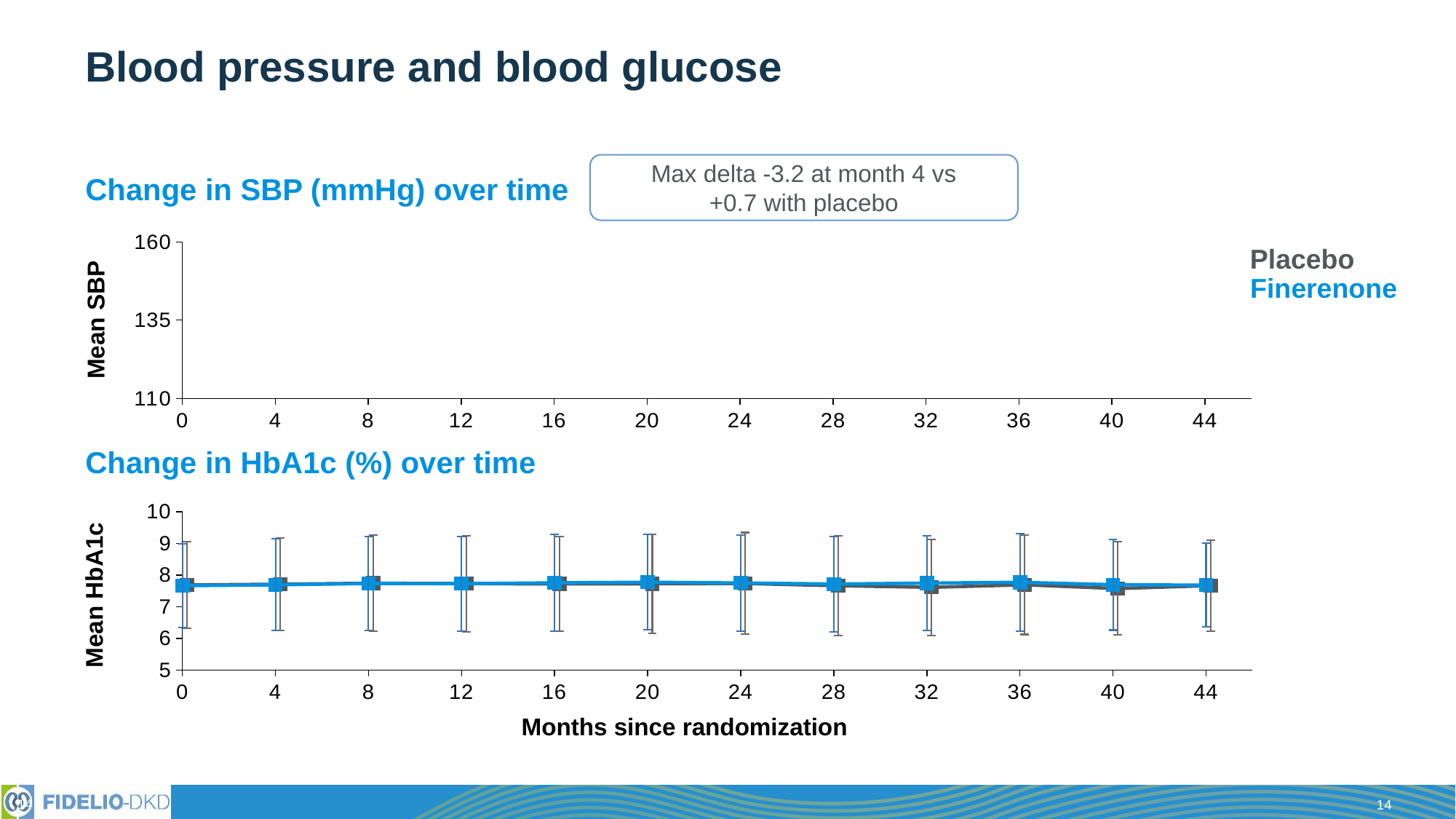
In the 'Change in HbA1c (%) over time' chart, is the Finerenone value at month 36 greater or less than 7? greater In the 'Change in HbA1c (%) over time' chart, is the Placebo value at month 0 greater or less than 6? greater In the 'Change in HbA1c (%) over time' chart, is the Finerenone value at month 20 greater or less than 8? less According to the callout on the SBP chart, what is the maximum delta in SBP with finerenone and at which month? -3.2 at month 4 In the 'Change in HbA1c (%) over time' chart, how many time points are plotted along the x axis? 12 Which colour represents Finerenone in the legend? blue In the 'Change in HbA1c (%) over time' chart, do the mean HbA1c values rise, fall or stay roughly flat from month 0 to month 44? roughly flat What kind of chart is the 'Change in HbA1c (%) over time' chart? line chart How many series does the legend list for the charts? 2 What is the x-axis label shown beneath the 'Change in HbA1c (%) over time' chart? Months since randomization